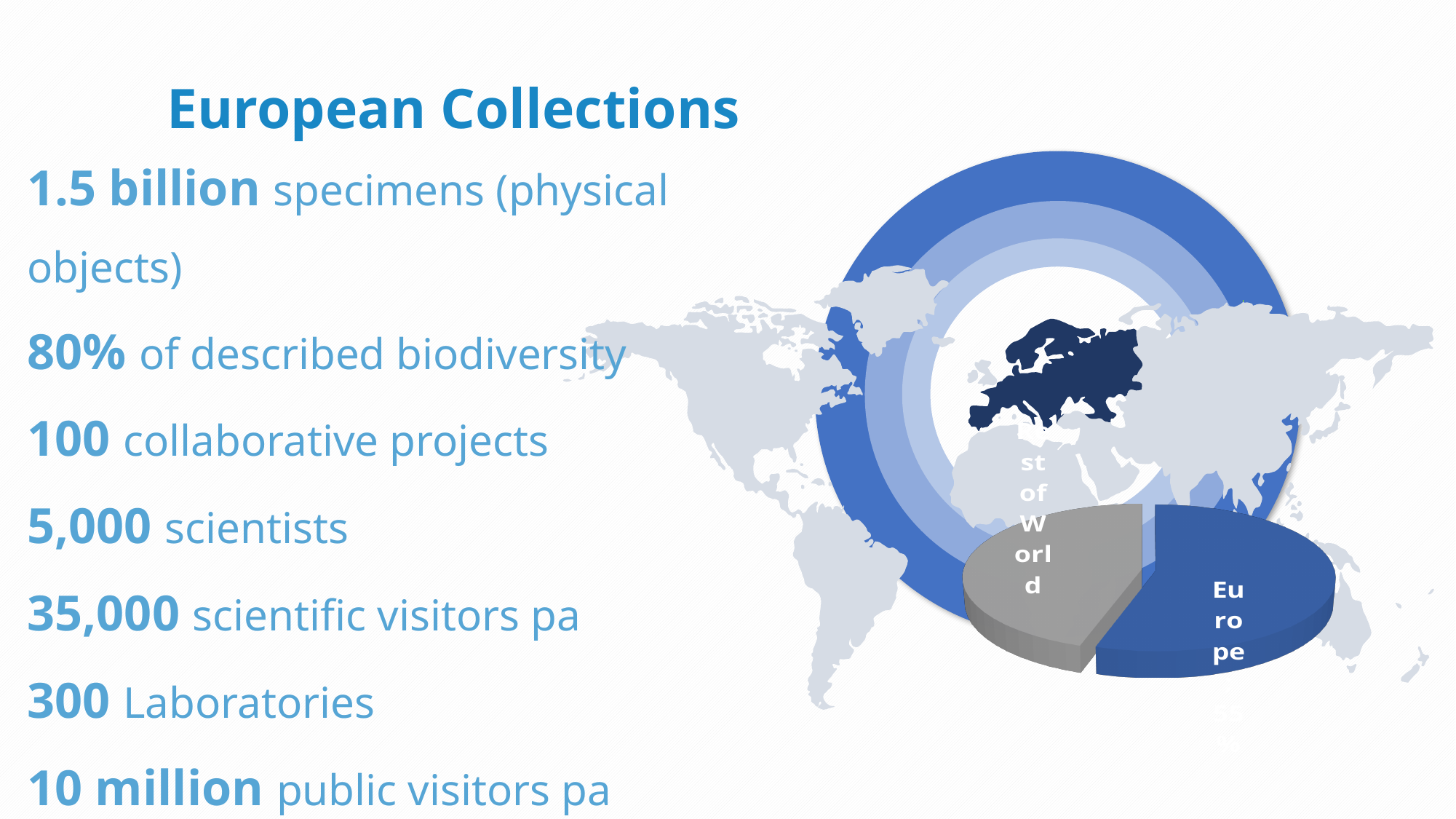
How many slices does the pie chart have? 2 Which slice of the pie chart is the largest? Europe Which slice of the pie chart is the smallest? Rest of World What colour is the Europe slice in the pie chart? blue In the pie chart, which is larger: the Europe slice or the Rest of World slice? Europe What kind of chart is shown on the right of the slide? pie chart What colour is the Rest of World slice in the pie chart? grey